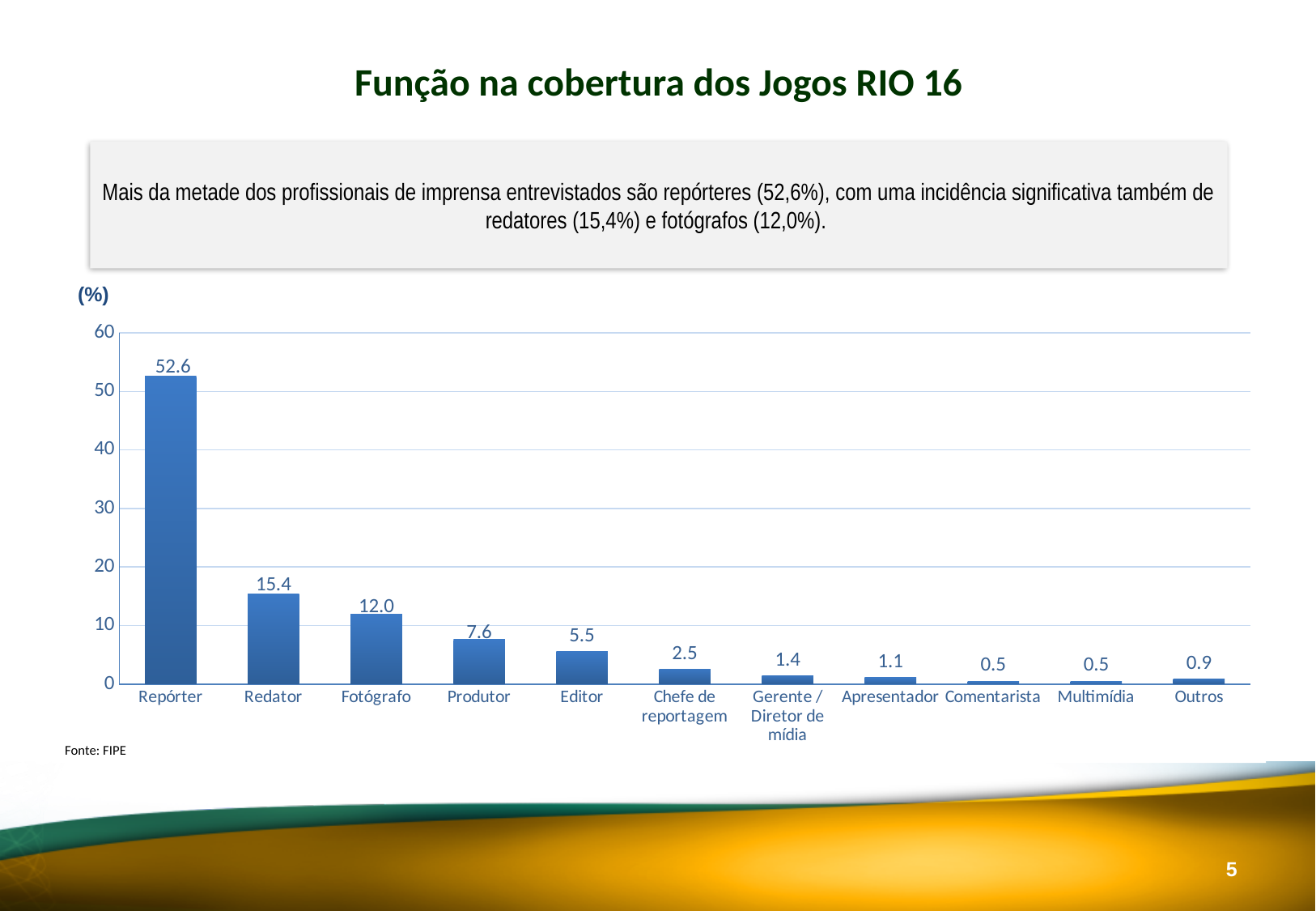
How many categories are shown on the x axis? 11 What kind of chart is shown on the slide? bar chart Which is larger, the value for Apresentador or the value for Outros? Apresentador Which category has the highest value? Repórter What is the difference between the values for Produtor and Editor? 2.1 Is the value for Redator greater or less than 20? less What is the value for Outros? 0.9 What is the value for Repórter? 52.6 What is the difference between the values for Redator and Fotógrafo? 3.4 What is the value for Fotógrafo? 12.0 What is the title of the slide? Função na cobertura dos Jogos RIO 16 What is the value for Chefe de reportagem? 2.5